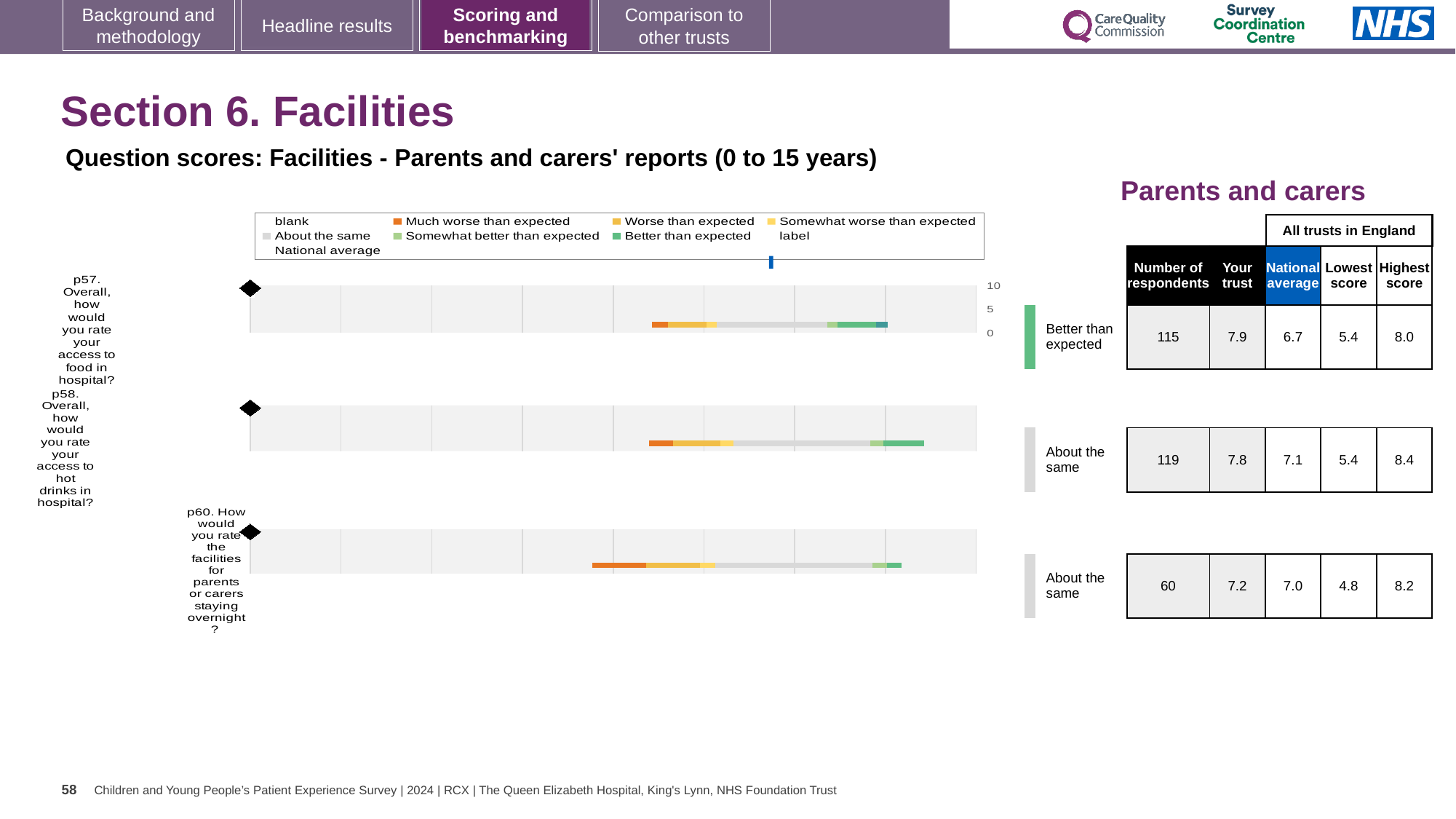
Which benchmark category is shown for p57 (access to food in hospital)? Better than expected Which question has the highest number of respondents? p58. Overall, how would you rate your access to hot drinks in hospital? What is the title of the chart section shown on the slide? Question scores: Facilities - Parents and carers' reports (0 to 15 years) What is the national average score for p58 (access to hot drinks in hospital)? 7.1 Which question has the lowest 'Lowest score' across all trusts in England? p60. How would you rate the facilities for parents or carers staying overnight? What is the 'Your trust' score for p57 (access to food in hospital)? 7.9 What is the difference between the 'Your trust' score and the national average for p57? 1.2 For p60, is the 'Your trust' score or the national average higher? Your trust How many respondents answered p60 (facilities for parents or carers staying overnight)? 60 Which benchmark category is shown for p60 (facilities for parents or carers staying overnight)? About the same What kind of chart is used to show the question scores on this slide? bar chart How many questions (categories) are plotted in the chart? 3